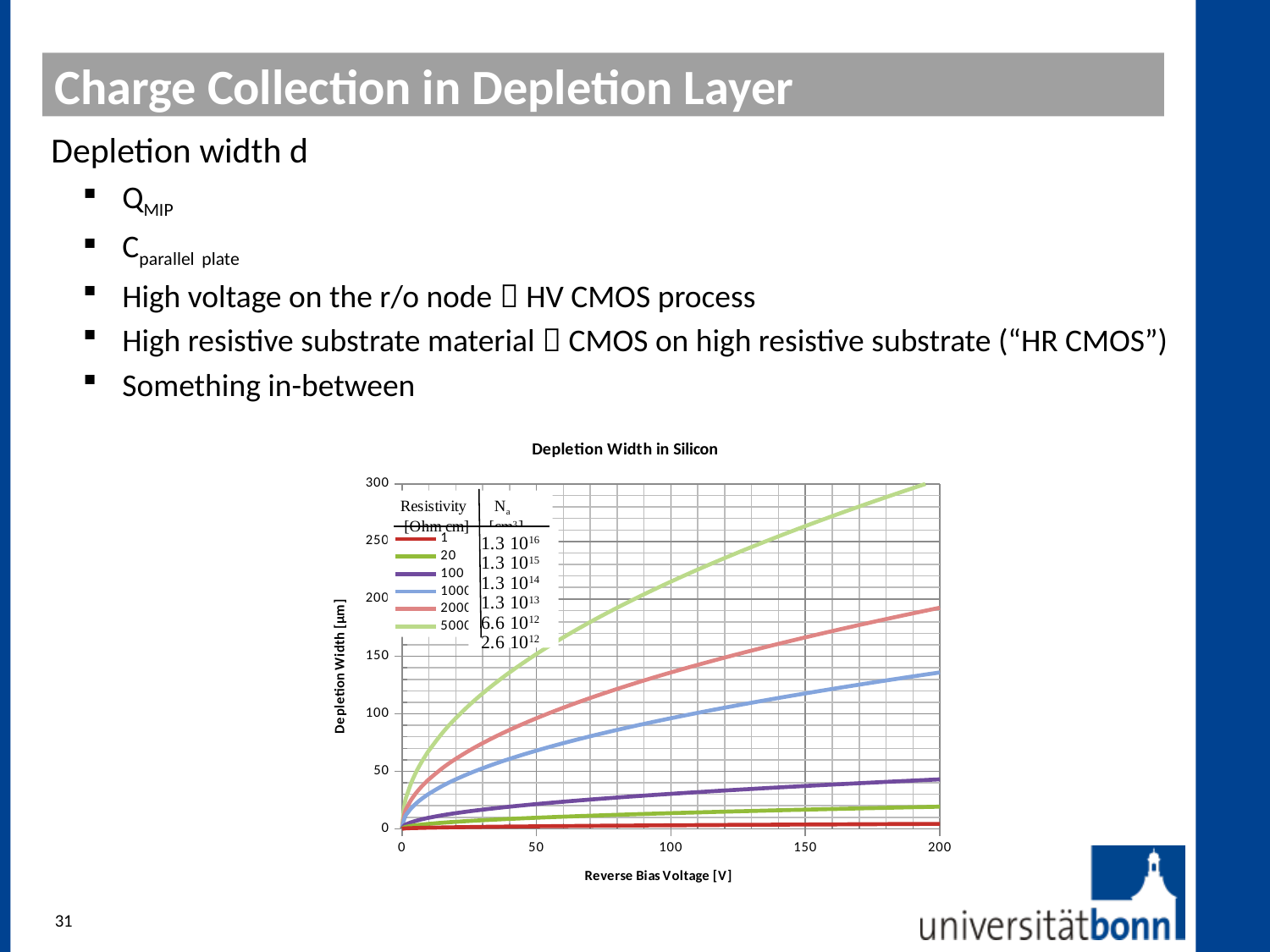
What is the title of the chart? Depletion Width in Silicon Is the depletion width for the 2000 Ohm cm series at 200 V greater or less than 150? greater Which resistivity series has the highest depletion width at a reverse bias voltage of 150 V? 5000 Is the depletion width for the 1000 Ohm cm series at 200 V greater or less than 100? greater What kind of chart is shown on the slide? line chart At 100 V, which series has the larger depletion width: 2000 Ohm cm or 1000 Ohm cm? 2000 Ohm cm Do the depletion width curves rise or fall as the reverse bias voltage increases? rise Is the depletion width for the 100 Ohm cm series at 200 V greater or less than 50? less How many series does the legend of the chart list? 6 Which resistivity series has the lowest depletion width at a reverse bias voltage of 200 V? 1 What is the label of the x axis of the chart? Reverse Bias Voltage [V]